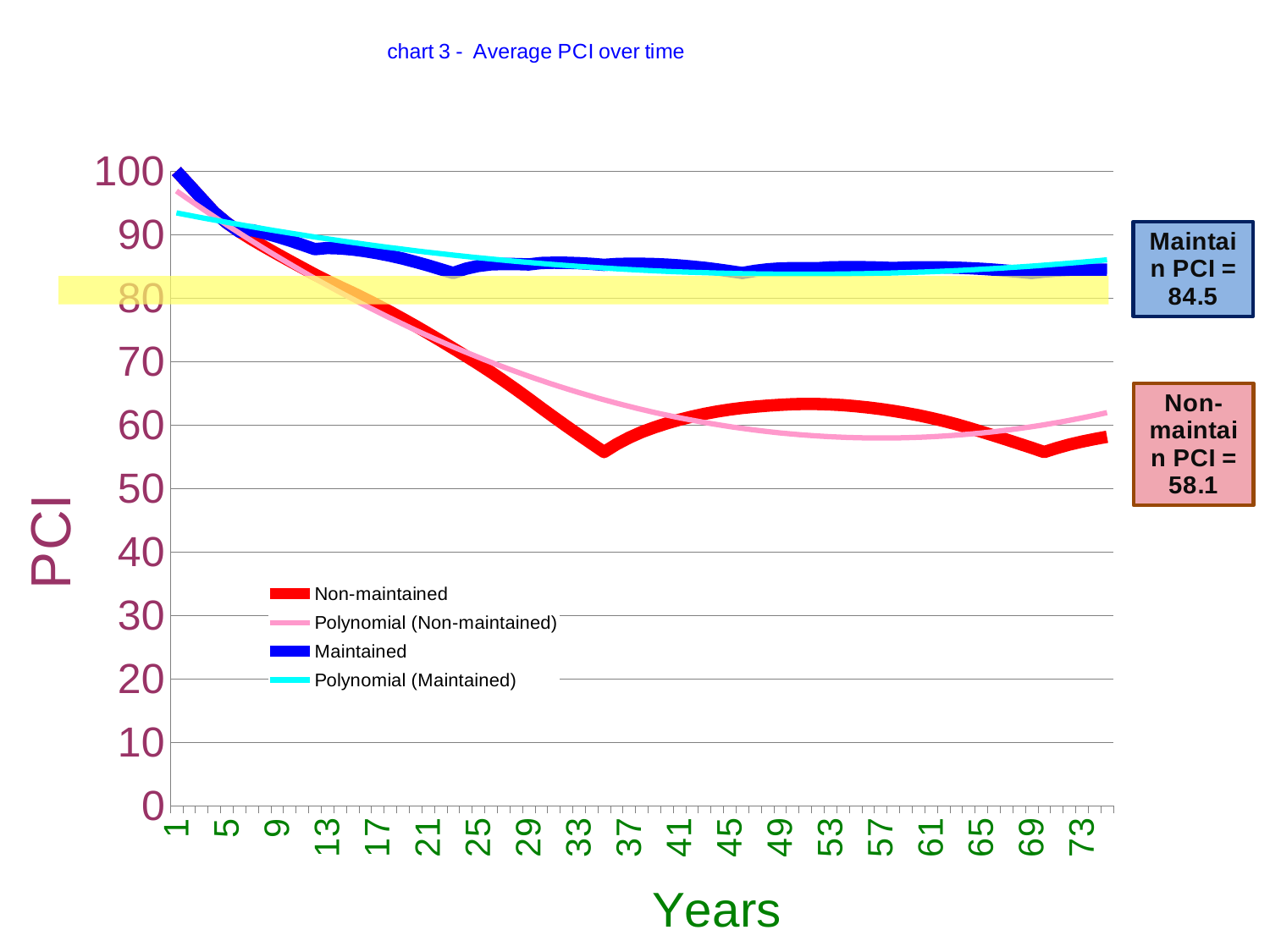
What is the label on the vertical axis? PCI What PCI value is given in the box labelled 'Non-maintain PCI'? 58.1 Is the Maintained value at year 49 greater or less than 80? greater What PCI value is given in the box labelled 'Maintain PCI'? 84.5 What kind of chart is shown on the slide? line chart What is the title of the chart? chart 3 - Average PCI over time Does the Non-maintained series rise or fall between year 1 and year 33? fall Is the Non-maintained value at year 49 greater or less than 60? greater At year 49, which series has the higher PCI, Maintained or Non-maintained? Maintained How many series does the legend list? 4 Is the Non-maintained value at year 33 greater or less than 60? less